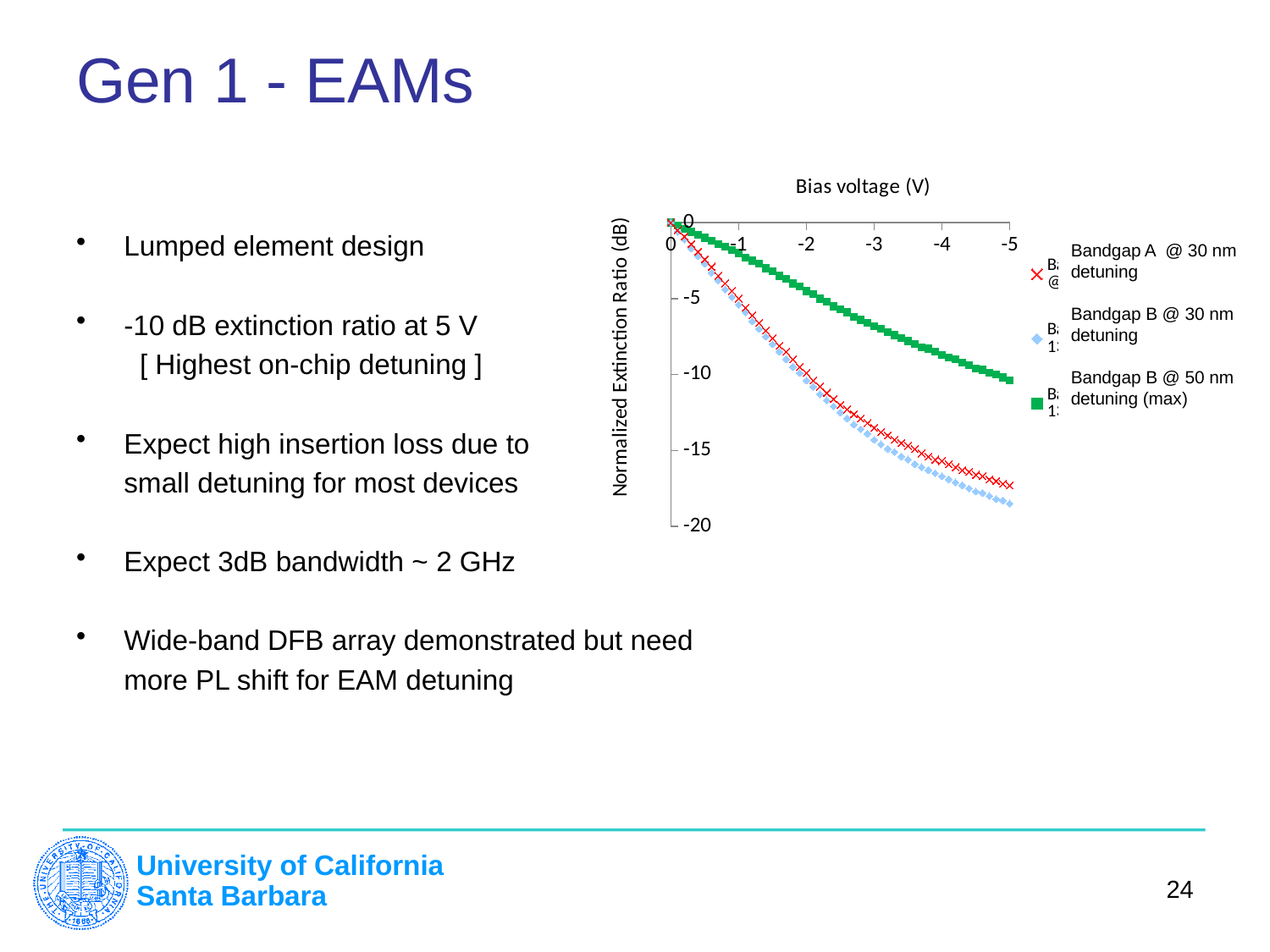
At a bias voltage of -4 V, is the normalized extinction ratio for Bandgap B @ 30 nm detuning greater or less than -10 dB? less What kind of chart is shown on the slide? Scatter chart Do the values of the Bandgap A @ 30 nm detuning series rise or fall as the bias voltage goes from 0 to -5 V? Fall At a bias voltage of -3 V, which series has a higher normalized extinction ratio: Bandgap A @ 30 nm detuning or Bandgap B @ 50 nm detuning (max)? Bandgap B @ 50 nm detuning (max) What is the title of the chart's y axis? Normalized Extinction Ratio (dB) At a bias voltage of -5 V, is the normalized extinction ratio for Bandgap B @ 50 nm detuning (max) greater or less than -15 dB? greater At a bias voltage of -5 V, is the normalized extinction ratio for Bandgap A @ 30 nm detuning greater or less than -15 dB? less At a bias voltage of -5 V, which series has the highest (least negative) normalized extinction ratio? Bandgap B @ 50 nm detuning (max) How many series does the chart's legend list? 3 Do the values of the Bandgap B @ 50 nm detuning (max) series rise or fall as the bias voltage goes from 0 to -5 V? Fall What is the title of the chart's x axis? Bias voltage (V)